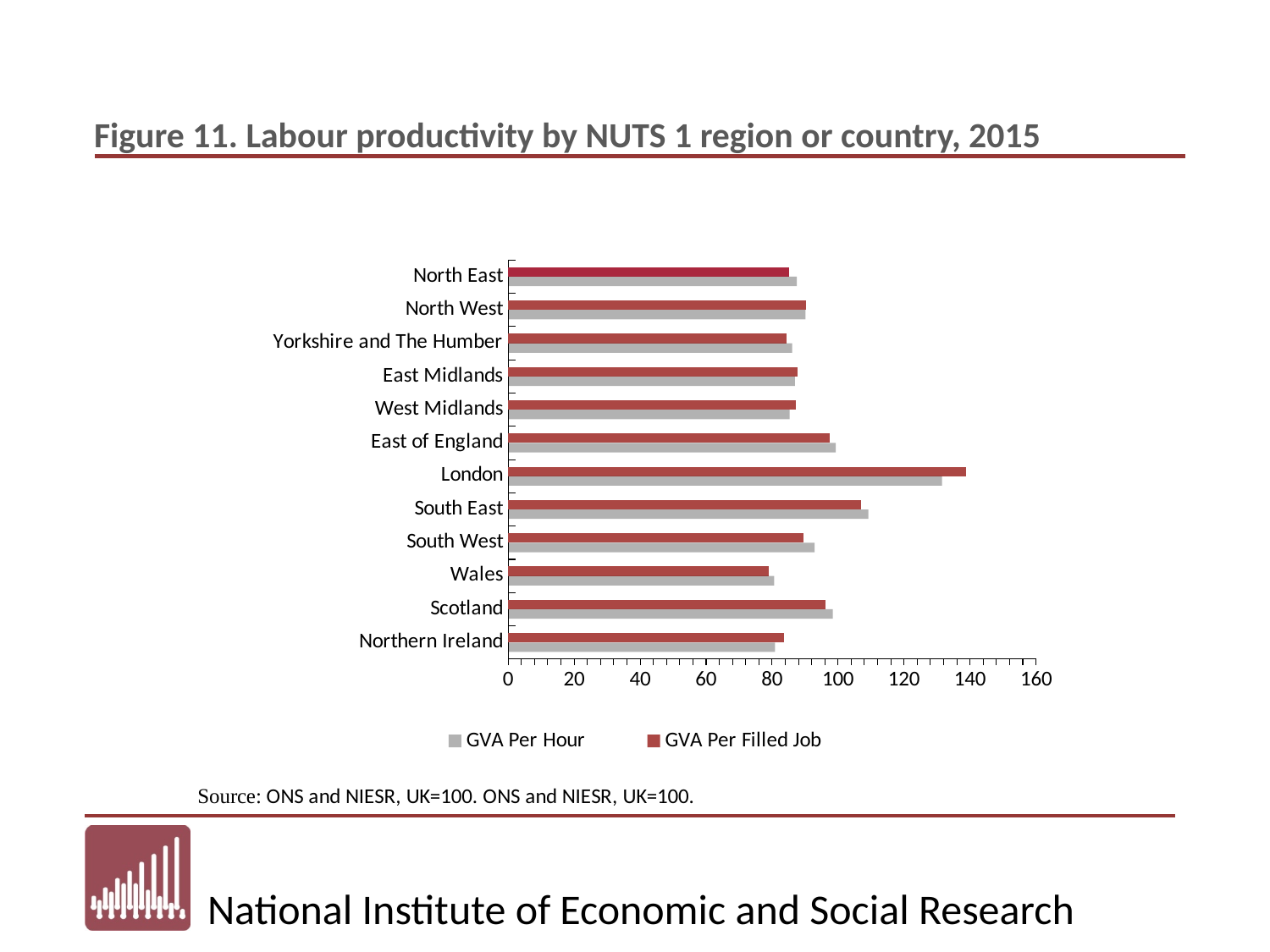
Is the GVA Per Hour value for London greater or less than 120? greater Which region has the lowest GVA Per Filled Job? Wales How many series does the legend list? 2 Which region has the highest GVA Per Hour? London Which region has the larger GVA Per Filled Job: London or South East? London Which region has the highest GVA Per Filled Job? London Which is larger for London: GVA Per Hour or GVA Per Filled Job? GVA Per Filled Job How many regions or countries are listed on the chart? 12 Is the GVA Per Filled Job value for Wales greater or less than 100? less Which colour represents GVA Per Filled Job in the legend? red What kind of chart is shown on the slide? bar chart Is the GVA Per Hour value for South East greater or less than 100? greater